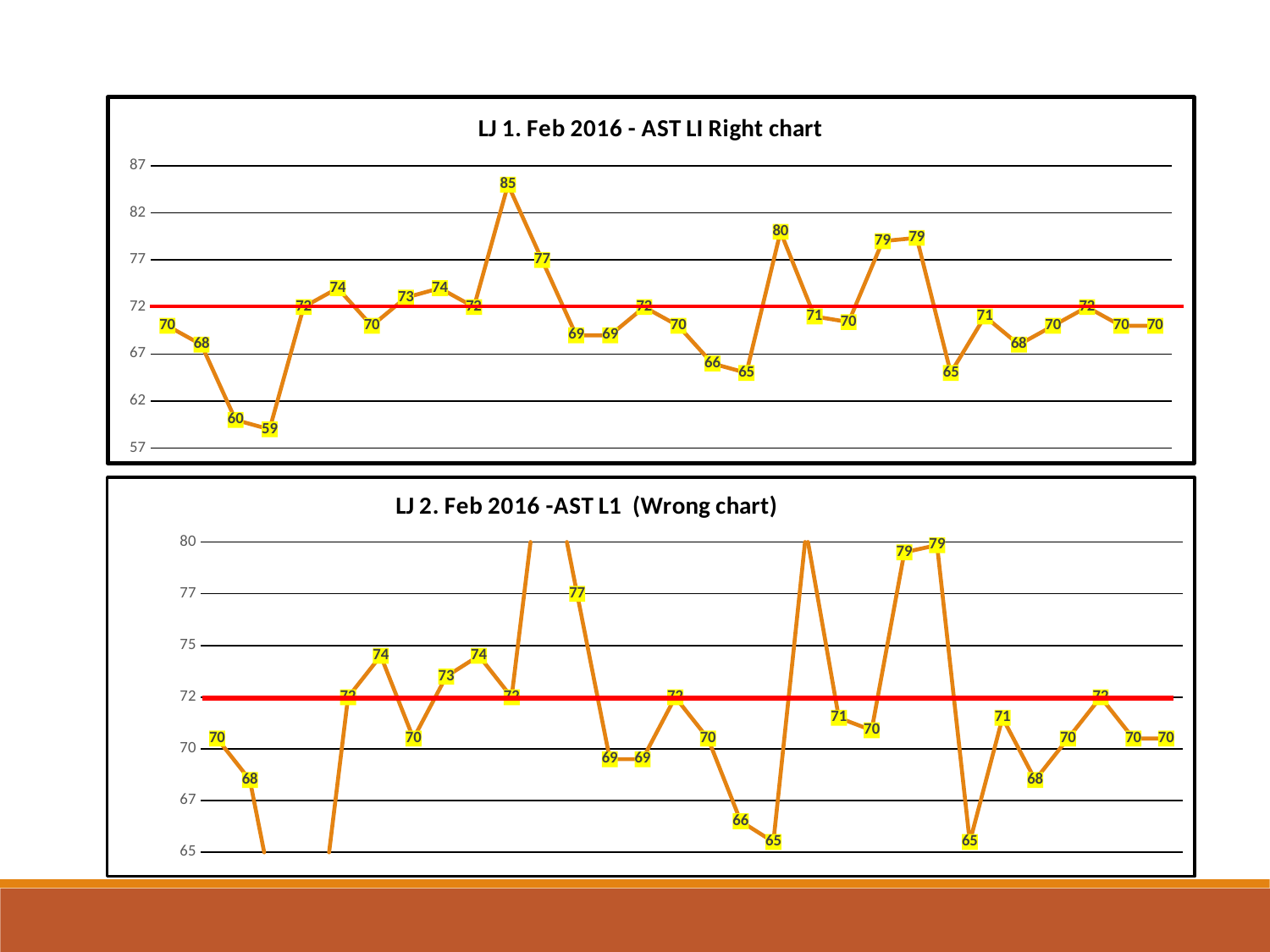
At what value is the horizontal red line drawn in both charts? 72 In the bottom chart (LJ 2), what is the value of the second data point from the left? 68 In the top chart (LJ 1), what is the lowest plotted value? 59 In the bottom chart (LJ 2), what is the highest value shown on the vertical axis? 80 In the top chart (LJ 1), is the value of the point labelled 85 greater or less than 82? greater In the top chart (LJ 1), what is the difference between the highest value (85) and the lowest value (59)? 26 In the top chart (LJ 1), what is the value of the last data point on the right? 70 In the top chart (LJ 1), which is larger: the peak labelled 80 or the peaks labelled 79? 80 In the bottom chart (LJ 2), what is the difference between the point labelled 77 and the point labelled 65 that follows the 66? 12 What kind of chart is the top chart titled "LJ 1. Feb 2016 - AST LI Right chart"? Line chart In the top chart (LJ 1), what is the value of the first data point on the left? 70 In the top chart (LJ 1), what is the highest plotted value? 85